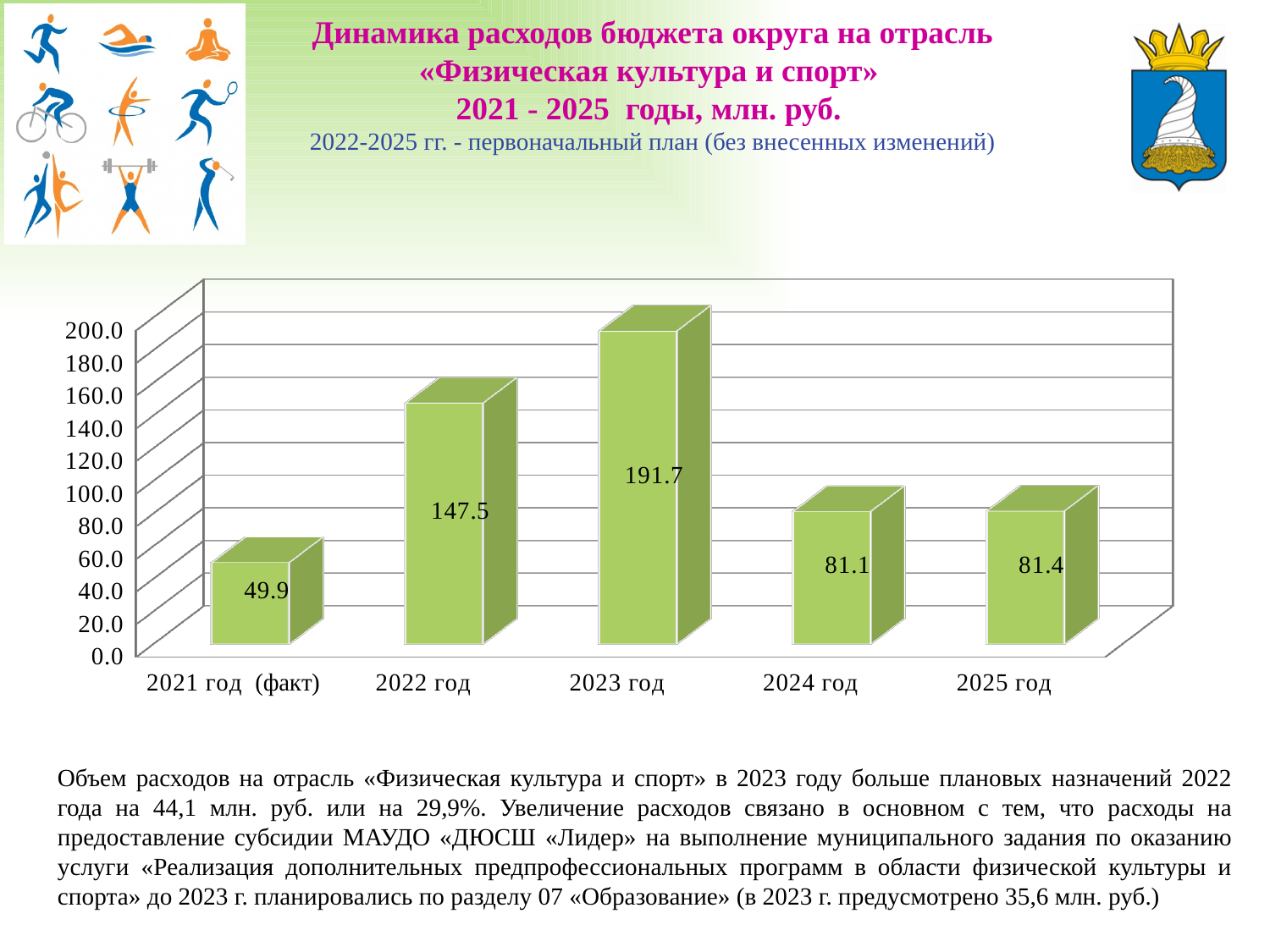
What is the difference between the values for 2025 год and 2024 год? 0.3 What is the difference between the values for 2023 год and 2022 год? 44.2 How many categories are shown on the x axis? 5 Which year has the lowest value? 2021 год (факт) Which is larger, the value for 2022 год or the value for 2024 год? 2022 год What kind of chart is shown on the slide? bar chart What is the value for 2025 год? 81.4 Is the value for 2023 год greater or less than 180.0? greater What is the value for 2023 год? 191.7 Which year has the highest value? 2023 год Do the values rise or fall from 2023 год to 2024 год? fall What is the value for 2021 год (факт)? 49.9